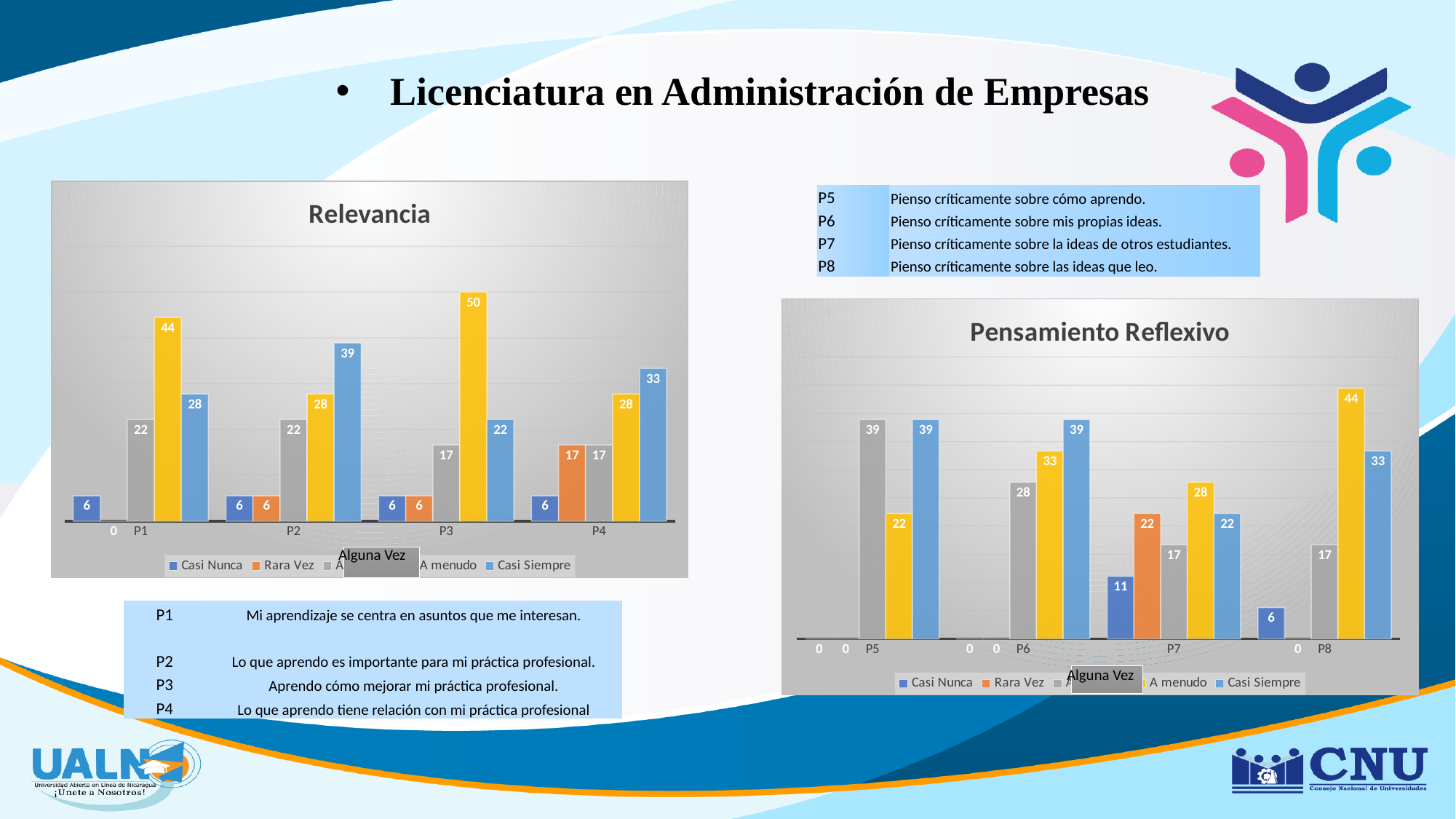
In the Pensamiento Reflexivo chart, what is the difference between the Casi Siempre value for P6 and the Casi Siempre value for P7? 17 In the Relevancia chart, what is the value of Casi Siempre for P2? 39 How many series does the legend of the Pensamiento Reflexivo chart list? 5 In the Pensamiento Reflexivo chart, what is the value of A menudo for P8? 44 In the Relevancia chart, which is larger for P4: Rara Vez or Casi Siempre? Casi Siempre In the Relevancia chart, how many categories are shown on the x axis? 4 In the Pensamiento Reflexivo chart, what is the value of Casi Nunca for P7? 11 In the Pensamiento Reflexivo chart, which category has the lowest Alguna Vez value? P7 and P8 (both 17) In the Relevancia chart, which category has the highest A menudo value? P3 In the Relevancia chart, what is the value of A menudo for P3? 50 What type of chart is the Relevancia chart? Bar chart In the Relevancia chart, what is the difference between the A menudo value for P1 and the Casi Siempre value for P1? 16